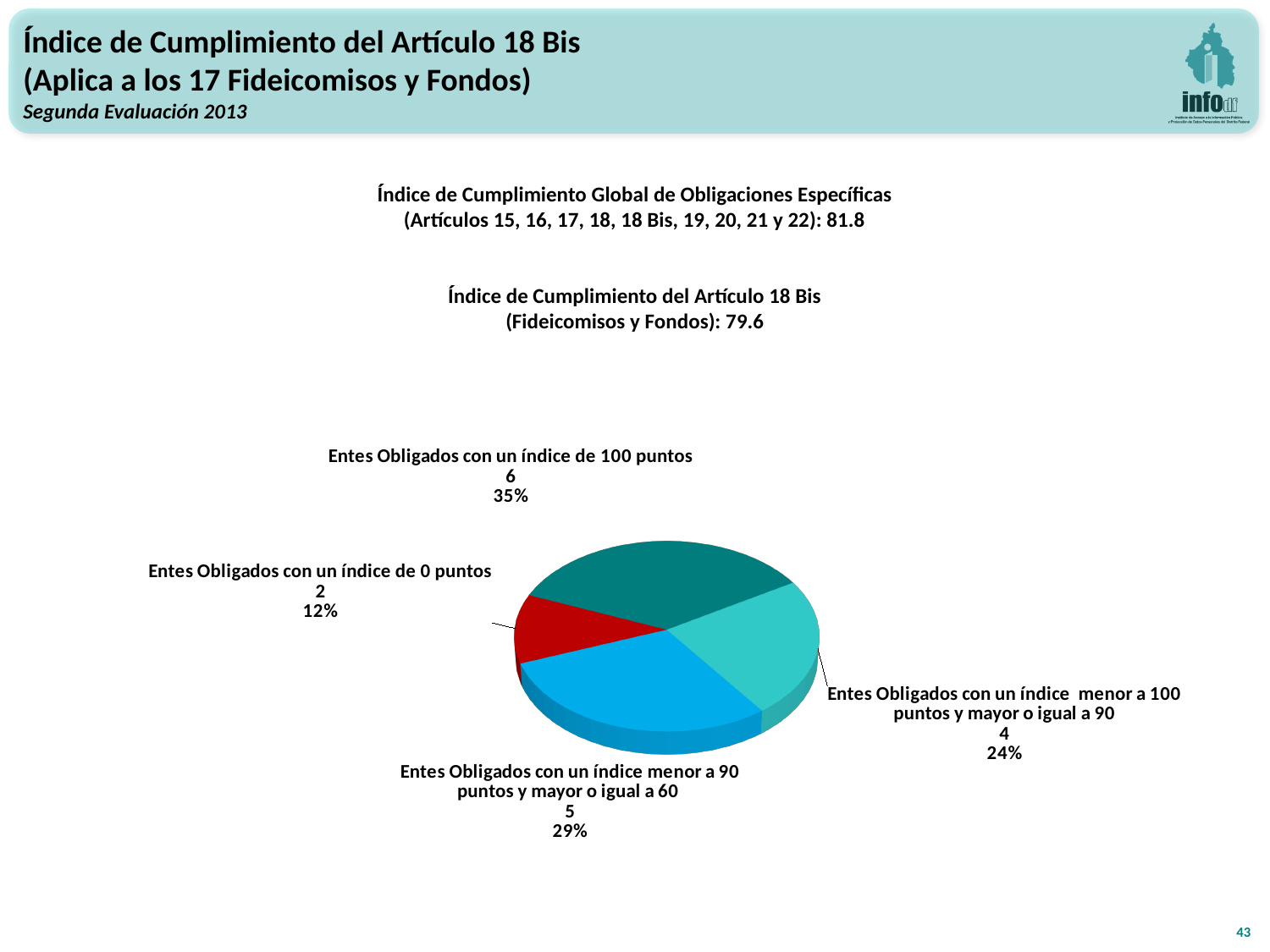
How many Entes Obligados have an índice de 100 puntos? 6 What percentage share of the pie corresponds to Entes Obligados con un índice de 0 puntos? 12% How many slices does the pie chart have? 4 What is the difference in count between Entes Obligados con un índice de 100 puntos and Entes Obligados con un índice de 0 puntos? 4 How many Entes Obligados have an índice menor a 90 puntos y mayor o igual a 60? 5 Which category has the smallest slice of the pie? Entes Obligados con un índice de 0 puntos What colour is the slice for Entes Obligados con un índice de 0 puntos? Red Which has more Entes Obligados: índice menor a 90 puntos y mayor o igual a 60, or índice menor a 100 puntos y mayor o igual a 90? Índice menor a 90 puntos y mayor o igual a 60 Which category has the largest slice of the pie? Entes Obligados con un índice de 100 puntos What percentage share of the pie corresponds to Entes Obligados con un índice menor a 100 puntos y mayor o igual a 90? 24% What is the total number of Entes Obligados across all four slices of the pie? 17 What kind of chart is shown on the slide? Pie chart